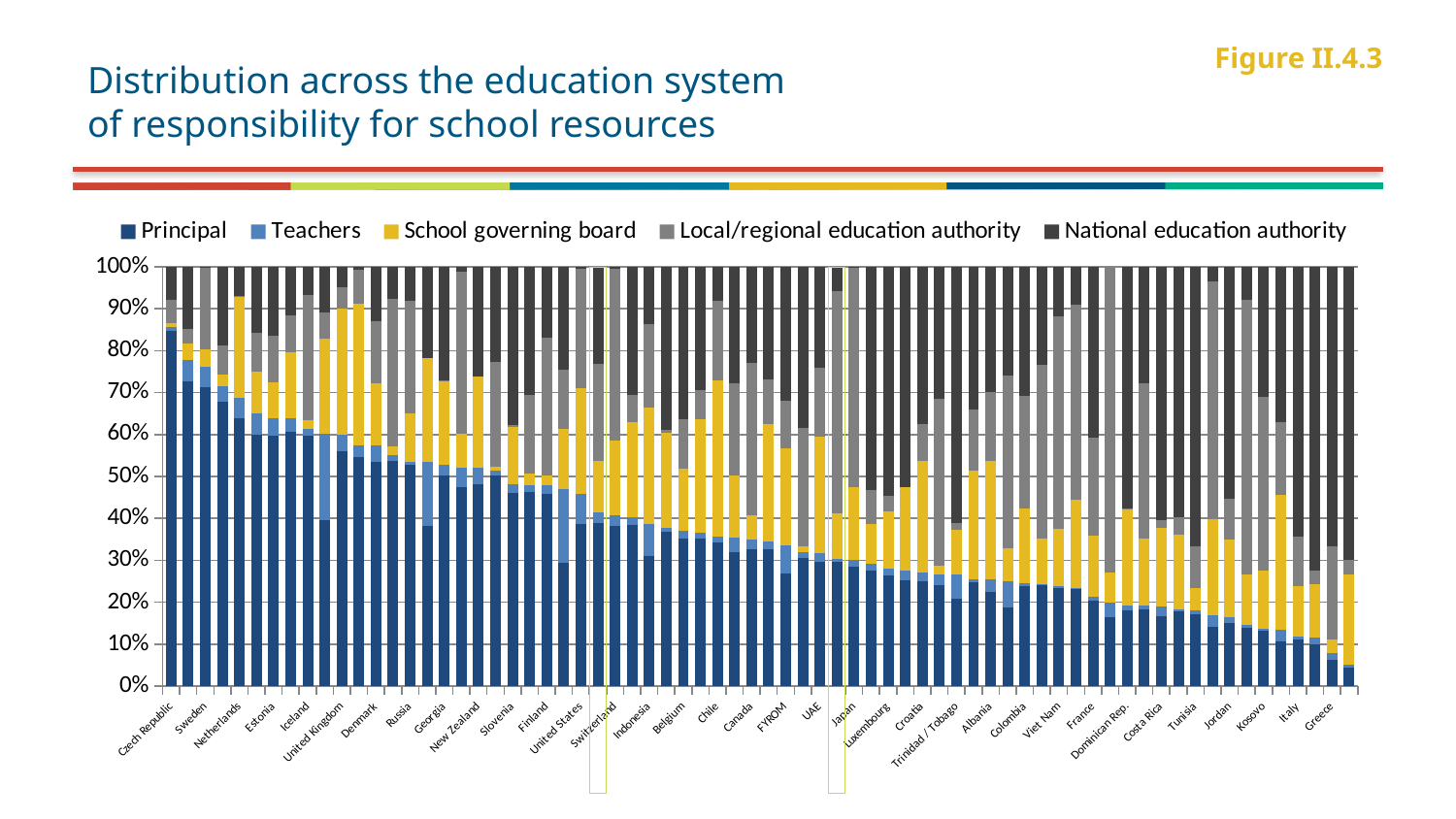
Is the Principal value for Netherlands greater or less than 50%? greater What is the figure number shown on the slide? Figure II.4.3 Is the Principal value for Sweden greater or less than 60%? greater Which has a larger Principal share, Czech Republic or Sweden? Czech Republic What do the segments of each stacked bar add up to? 100% Is the Principal value for Greece greater or less than 20%? less What kind of chart is shown on the slide? Stacked bar chart How many series does the legend list? 5 Which country has the highest Principal share? Czech Republic Does the Principal share rise or fall moving from left to right along the x axis? Fall Which series is listed first in the legend? Principal